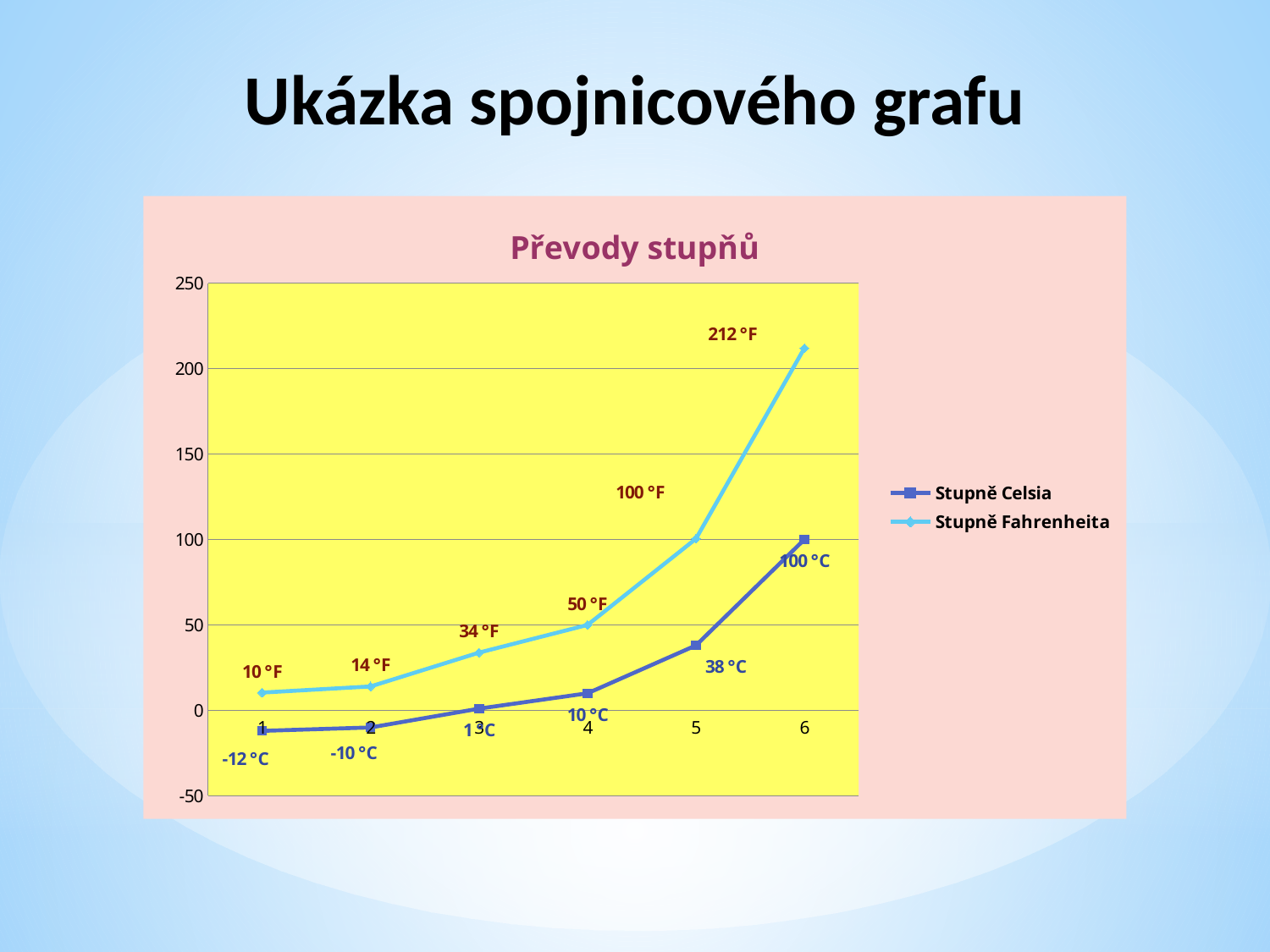
At which category does the Stupně Fahrenheita series reach its highest value? 6 Which series has the larger value at category 4, Stupně Celsia or Stupně Fahrenheita? Stupně Fahrenheita What is the value of the Stupně Fahrenheita series at category 3? 34 °F How many points are plotted along the x axis for each series in the "Převody stupňů" chart? 6 How many series does the legend of the "Převody stupňů" chart list? 2 What is the difference between the Stupně Fahrenheita values at category 6 and category 5? 112 °F What kind of chart is shown under the title "Převody stupňů"? line chart At which category does the Stupně Celsia series have its lowest value? 1 What is the value of the Stupně Celsia series at category 1? -12 °C What is the value of the Stupně Fahrenheita series at category 6? 212 °F What is the value of the Stupně Celsia series at category 5? 38 °C Do the values of the Stupně Celsia series rise or fall from category 1 to category 6? rise